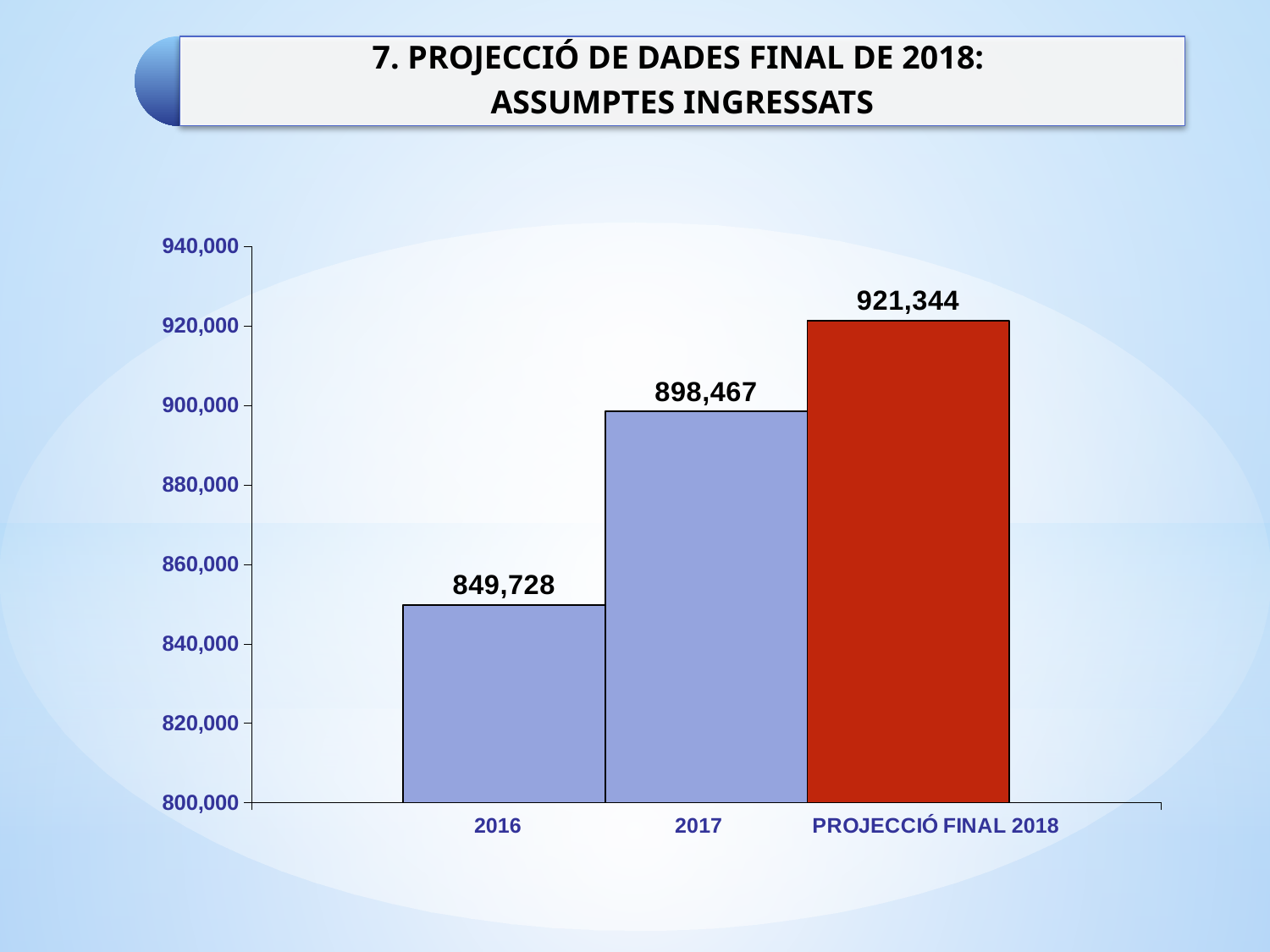
What is the value for PROJECCIÓ FINAL 2018? 921,344 How many categories are shown on the x axis? 3 What kind of chart is shown on the slide? bar chart Which category has the highest value? PROJECCIÓ FINAL 2018 Which category has the lowest value? 2016 Do the values rise or fall from 2016 to PROJECCIÓ FINAL 2018? rise Is the value for 2017 greater or less than 900,000? less What is the value for 2017? 898,467 What is the difference between the values for PROJECCIÓ FINAL 2018 and 2017? 22,877 What is the value for 2016? 849,728 What is the difference between the values for 2017 and 2016? 48,739 Which is larger, the value for 2016 or the value for 2017? 2017